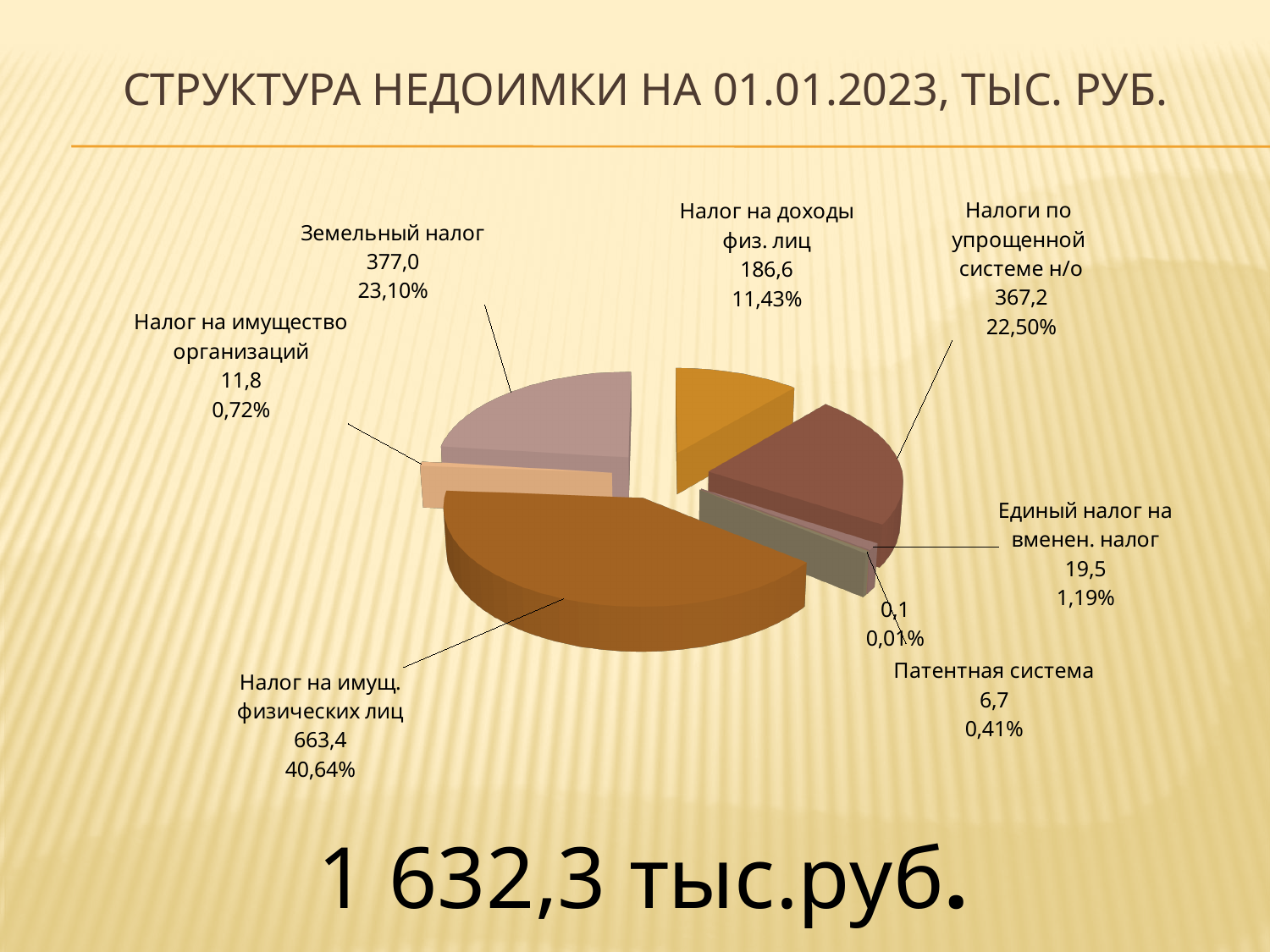
What is the title of the slide? СТРУКТУРА НЕДОИМКИ НА 01.01.2023, ТЫС. РУБ. What is the difference between the values for Земельный налог and Налоги по упрощенной системе н/о? 9,8 What kind of chart is shown on the slide? Pie chart What is the value for Единый налог на вменен. налог? 19,5 What share of the pie does Налог на доходы физ. лиц represent? 11,43% Which category has the largest value? Налог на имущ. физических лиц What share of the pie does Налог на имущ. физических лиц represent? 40,64% Which is larger: Земельный налог or Налоги по упрощенной системе н/о? Земельный налог What is the value for Земельный налог? 377,0 What is the difference between the values for Налог на имущ. физических лиц and Налог на доходы физ. лиц? 476,8 What share of the pie does Патентная система represent? 0,41% What is the total amount shown below the chart? 1 632,3 тыс.руб.